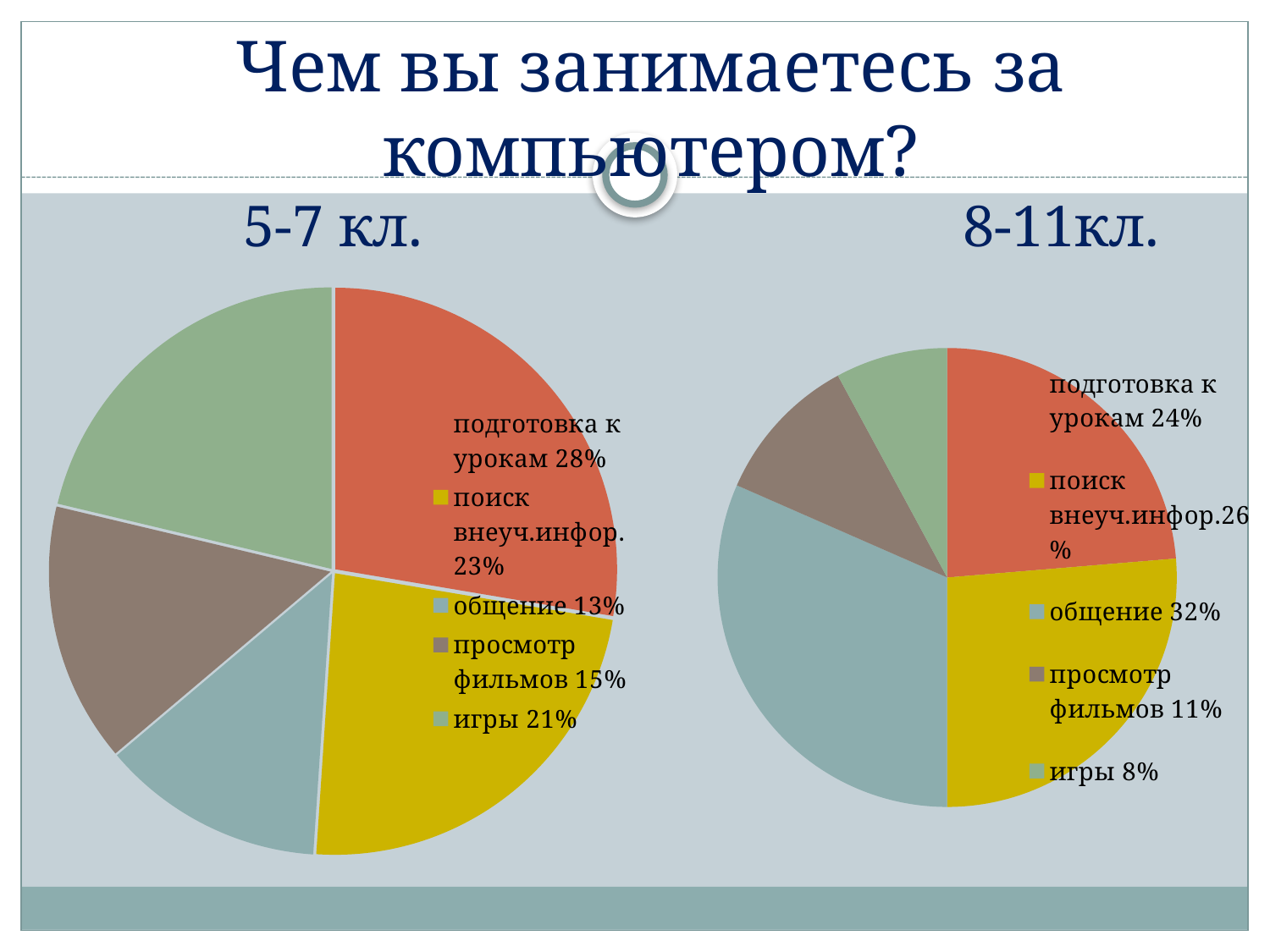
In the 8-11кл. chart, what share is shown for игры? 8% In the 5-7 кл. chart, what share is shown for подготовка к урокам? 28% In the 5-7 кл. chart, what share is shown for поиск внеуч.инфор.? 23% In the 8-11кл. chart, which category has the smallest share? игры What type of chart is used on the slide for the 5-7 кл. group? pie chart In the 8-11кл. chart, what share is shown for общение? 32% In the 8-11кл. chart, which category has the largest share? общение How many categories does the legend of the 8-11кл. chart list? 5 What is the title of the slide containing the two pie charts? Чем вы занимаетесь за компьютером? Which group has the larger share for игры: 5-7 кл. or 8-11кл.? 5-7 кл. In the 5-7 кл. chart, what share is shown for просмотр фильмов? 15% In the 8-11кл. chart, what is the difference between the shares for общение and подготовка к урокам? 8%